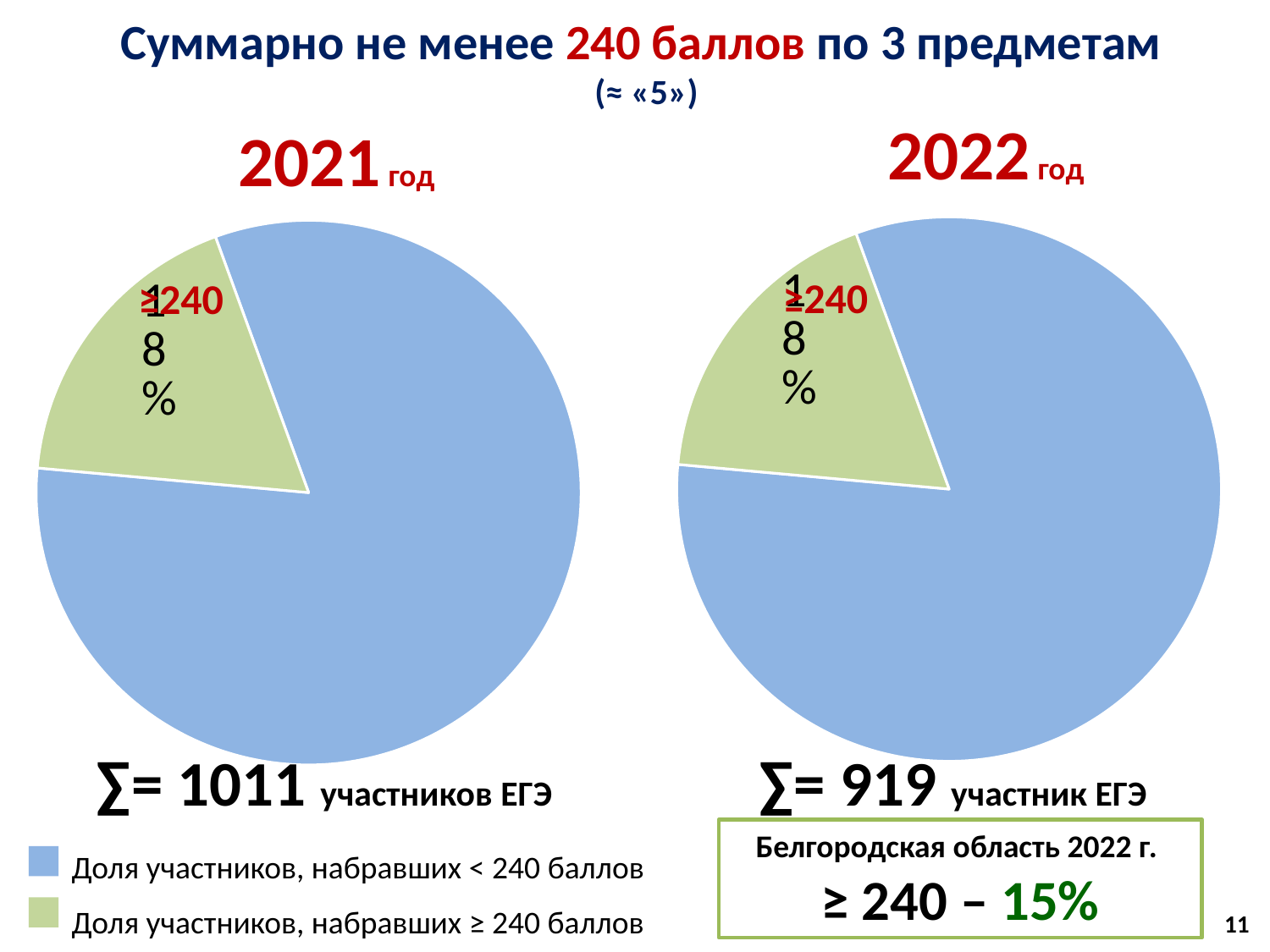
In the 2022 год pie chart, what share of participants scored ≥ 240 баллов? 18% How many categories does the legend list? 2 In the 2021 год pie chart, what share of participants scored ≥ 240 баллов? 18% In the 2021 год pie chart, which category has the smallest slice? Доля участников, набравших ≥ 240 баллов What kind of chart is used for the 2021 год data? pie chart In the 2022 год pie chart, which category has the largest slice? Доля участников, набравших < 240 баллов In the 2022 год pie chart, which slice is larger: participants with < 240 баллов or participants with ≥ 240 баллов? Доля участников, набравших < 240 баллов What colour represents participants who scored ≥ 240 баллов in the pie charts? green How many slices does the 2021 год pie chart have? 2 What is the total number of ЕГЭ participants shown under the 2021 год pie chart? 1011